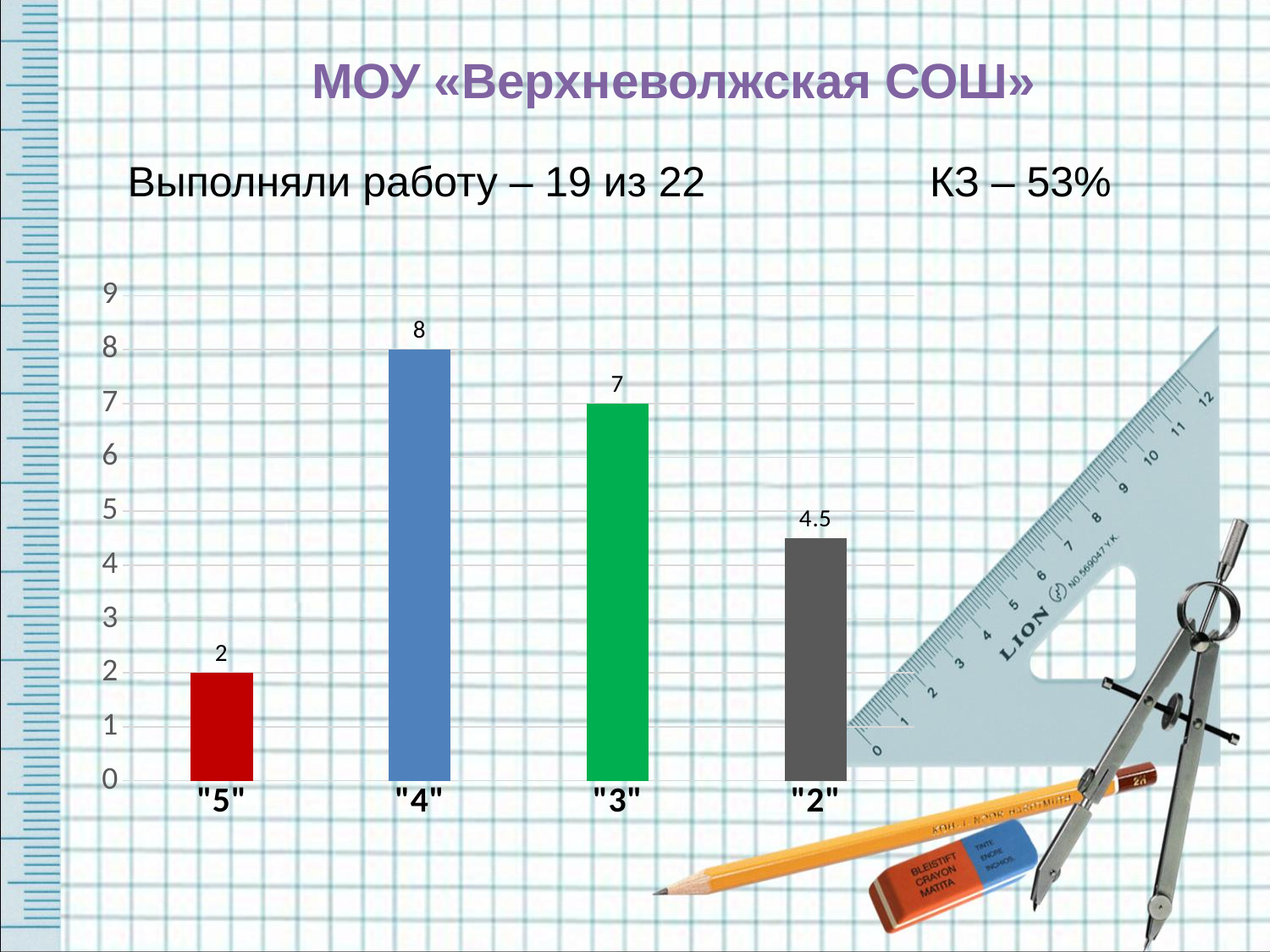
Which is larger, the value for "3" or the value for "2"? "3" What is the value for the "4" category? 8 What is the value for the "2" category? 4.5 Which category has the lowest value? "5" What is the difference between the values for "4" and "3"? 1 What kind of chart is shown on the slide? bar chart Which category has the highest value? "4" How many categories are shown on the x axis? 4 What is the difference between the values for "3" and "2"? 2.5 Is the value for "2" greater or less than 5? less What colour is the bar for the "3" category? green What is the value for the "5" category? 2